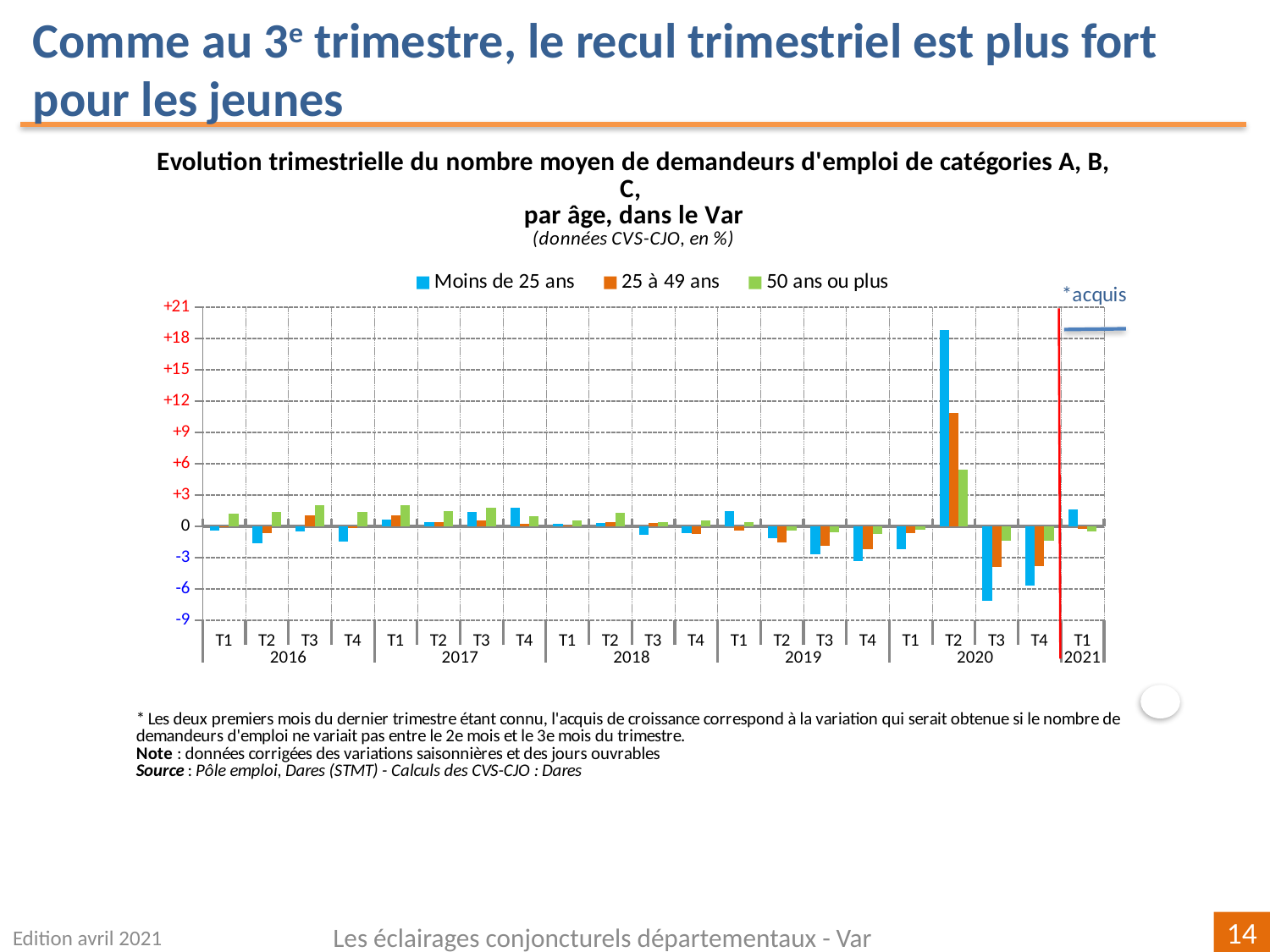
What kind of chart is shown on the slide? bar chart In which quarter does the 'Moins de 25 ans' series reach its lowest value? T3 2020 Is the value for '25 à 49 ans' in T2 2020 greater or less than +9? greater Which age groups are listed in the legend? Moins de 25 ans, 25 à 49 ans, 50 ans ou plus In which quarter does the 'Moins de 25 ans' series reach its highest value? T2 2020 Which quarter is marked as 'acquis' to the right of the red vertical line? T1 2021 In T2 2020, which is larger: the value for 'Moins de 25 ans' or for '50 ans ou plus'? Moins de 25 ans How many series does the legend list? 3 Is the value for 'Moins de 25 ans' in T3 2020 greater or less than -6? less How many quarters are shown along the x axis? 21 Is the value for 'Moins de 25 ans' in T4 2020 greater or less than -3? less